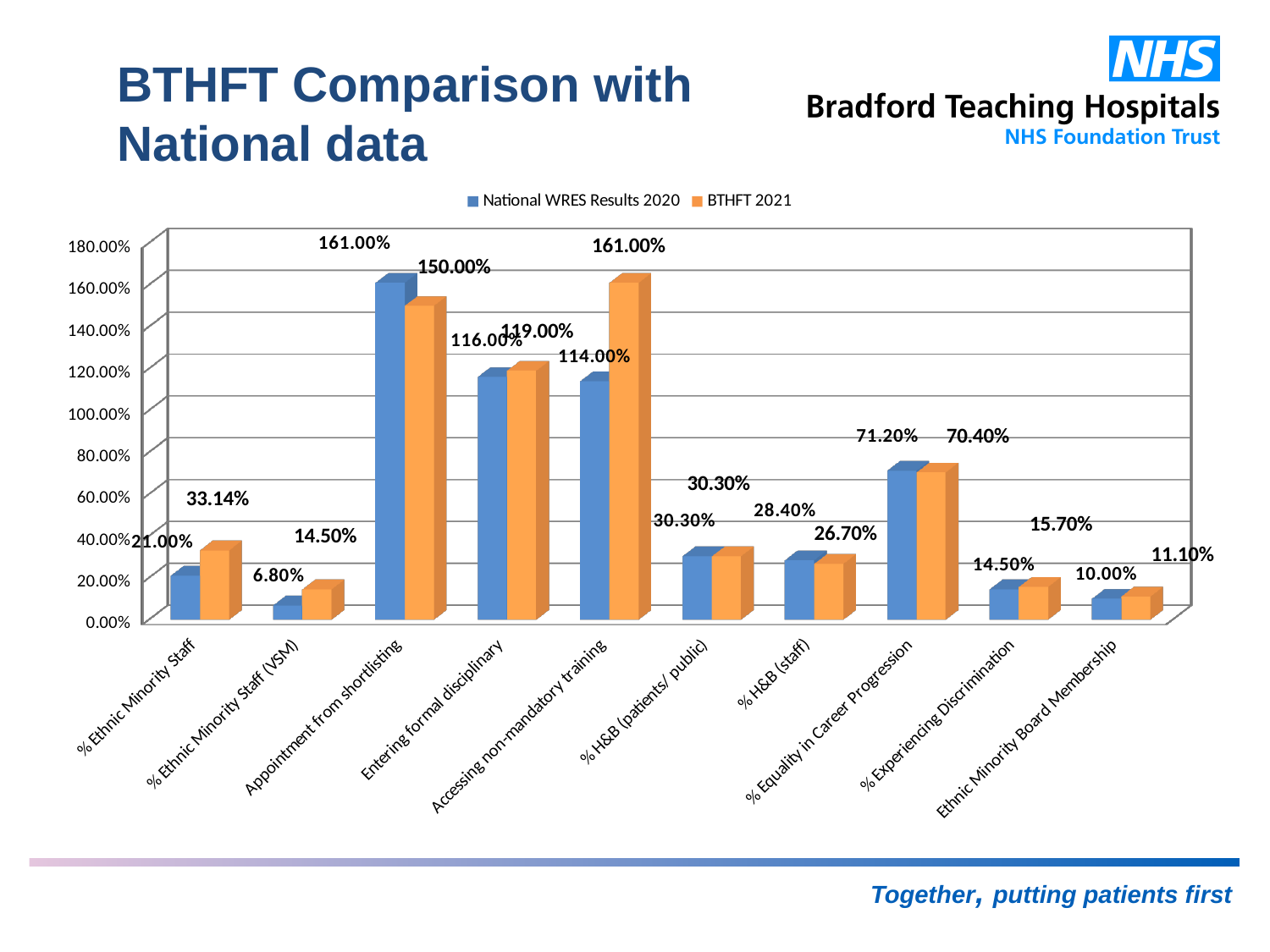
What is the BTHFT 2021 value for % Ethnic Minority Staff? 33.14% What is the BTHFT 2021 value for Accessing non-mandatory training? 161.00% What is the difference between the BTHFT 2021 and National WRES Results 2020 values for Accessing non-mandatory training? 47.00% What is the National WRES Results 2020 value for Appointment from shortlisting? 161.00% What is the National WRES Results 2020 value for % Ethnic Minority Staff (VSM)? 6.80% What kind of chart is shown on the slide? Bar chart How many series does the chart legend list? 2 Which category has the lowest National WRES Results 2020 value? % Ethnic Minority Staff (VSM) For Appointment from shortlisting, which is larger: the National WRES Results 2020 value or the BTHFT 2021 value? National WRES Results 2020 How many categories are shown on the x axis of the chart? 10 Which category has the highest BTHFT 2021 value? Accessing non-mandatory training Is the BTHFT 2021 value for % Equality in Career Progression greater or less than 60.00%? greater